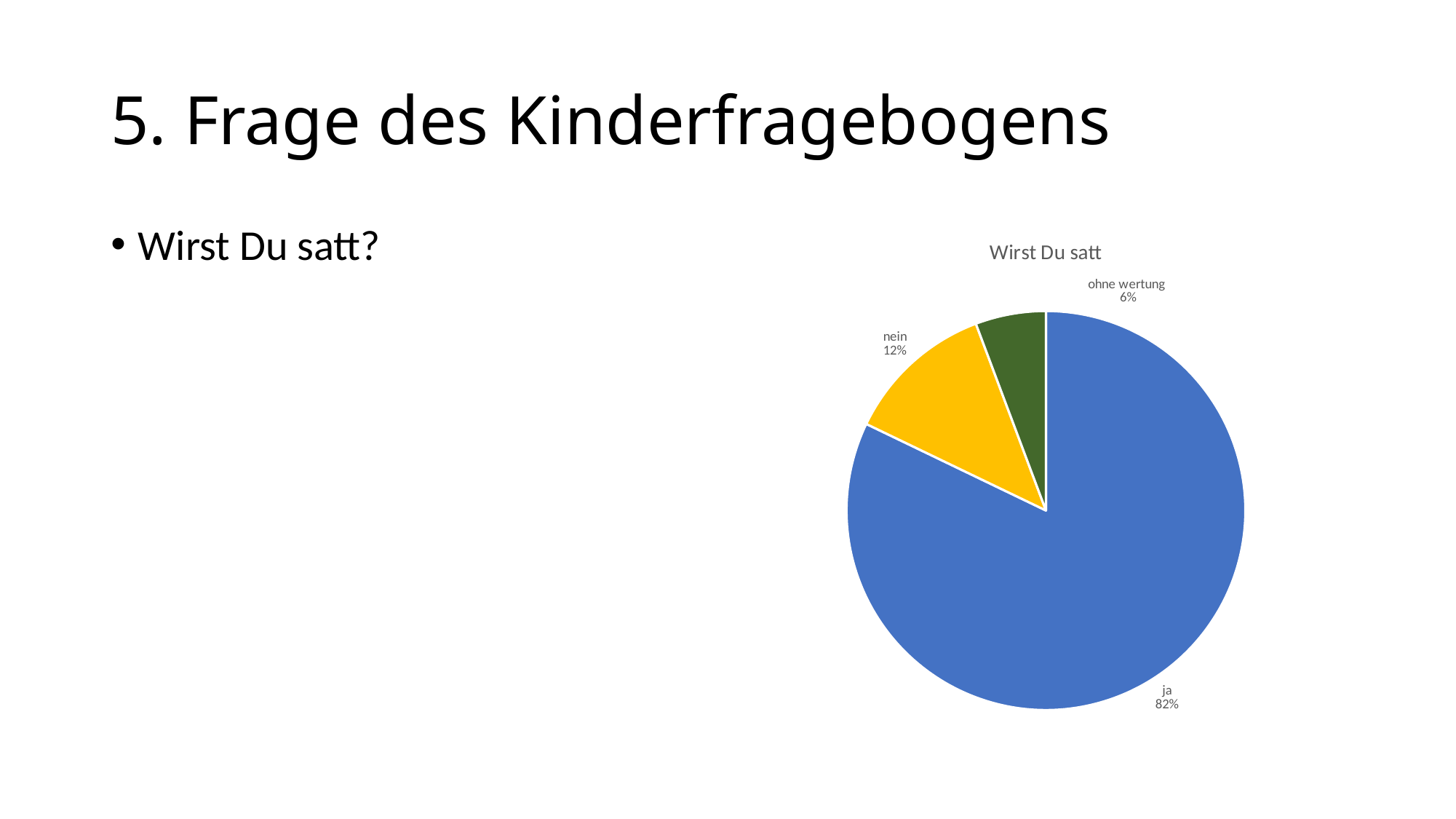
What share of the pie does the "nein" slice represent? 12% What is the title of the chart? Wirst Du satt What kind of chart is shown on the slide? pie chart What share of the pie does the "ohne wertung" slice represent? 6% How many slices does the pie chart have? 3 Which slice is larger, "nein" or "ohne wertung"? nein Which category has the smallest slice of the pie? ohne wertung Which category has the largest slice of the pie? ja What share of the pie does the "ja" slice represent? 82% What colour is the "ja" slice? blue What is the difference in percentage points between the "ja" and "nein" slices? 70 What is the difference in percentage points between the "nein" and "ohne wertung" slices? 6